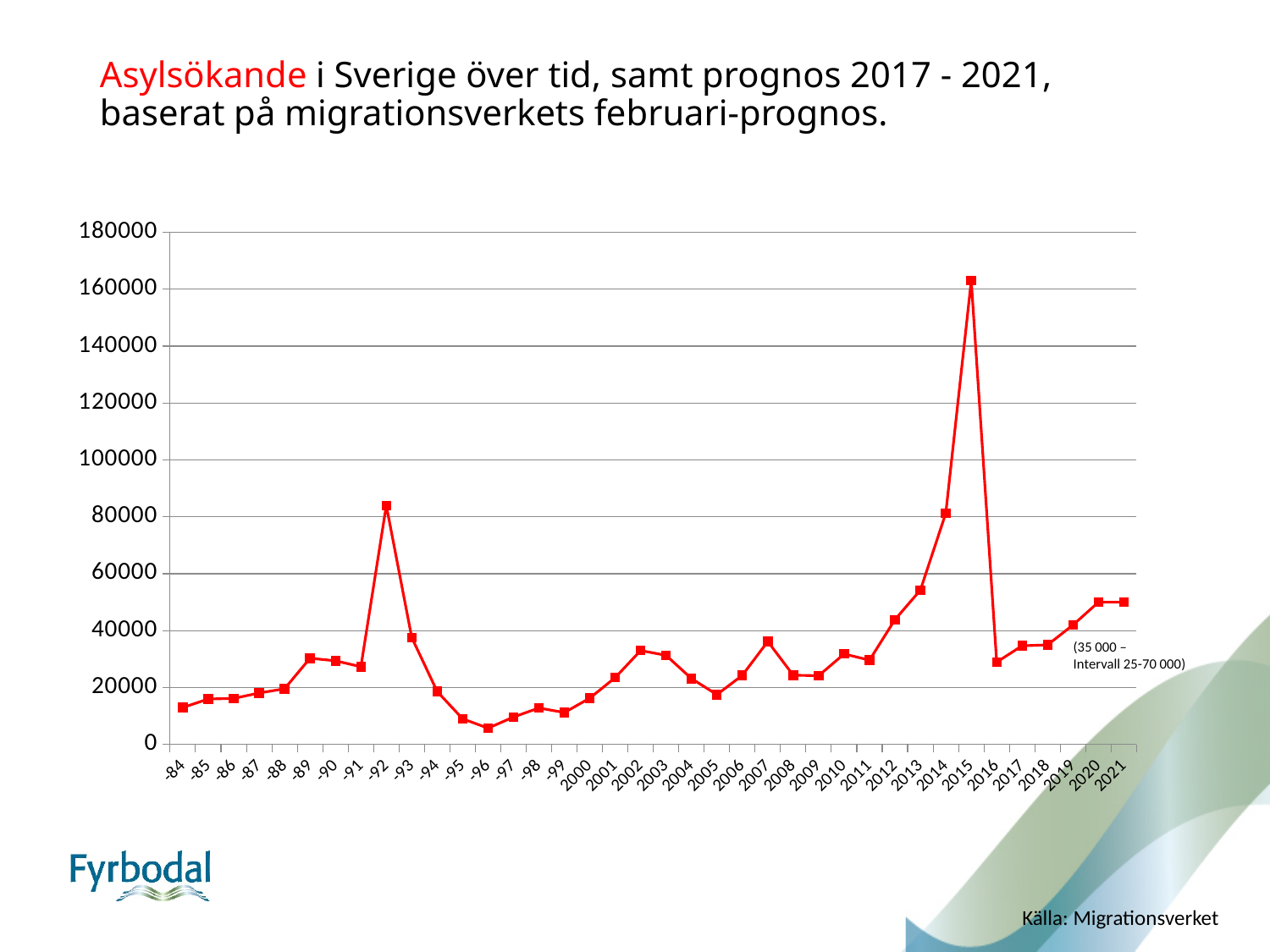
Is the value for -92 greater or less than 60000? greater Which is larger, the value for 2002 or the value for 2005? 2002 Is the value for 2015 greater or less than 140000? greater Do the values rise or fall from 2016 to 2021? rise What source is cited for the chart data? Migrationsverket How many years (data points) are plotted on the x axis? 38 Which year has the lowest value in the chart? -96 Is the value for 2021 greater or less than 40000? greater Which year has the highest number of asylum seekers in the chart? 2015 What kind of chart is shown on the slide? line chart Which is larger, the value for -92 or the value for 2015? 2015